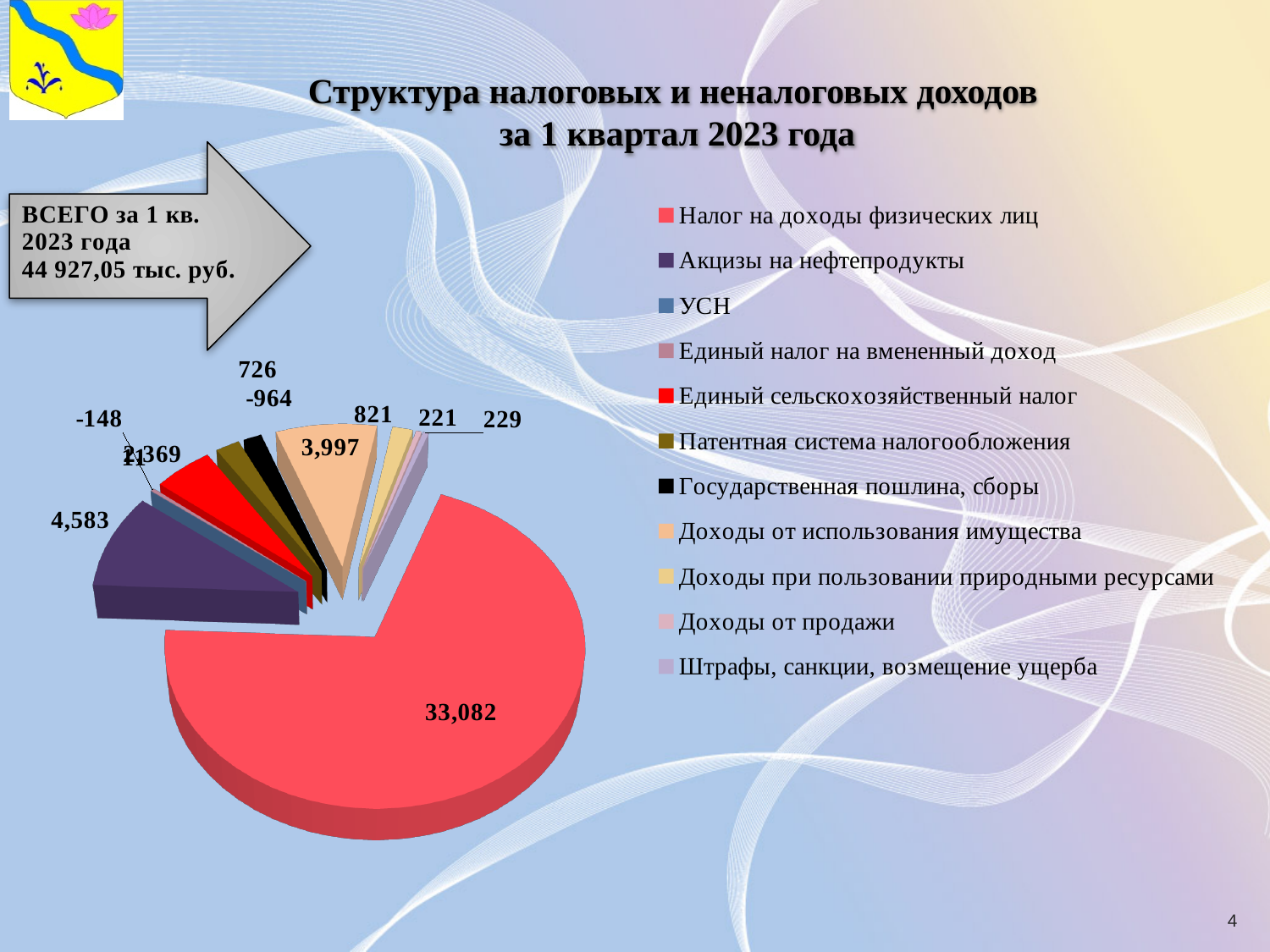
What is the title of the chart on the slide? Структура налоговых и неналоговых доходов за 1 квартал 2023 года Which is larger: the value for Акцизы на нефтепродукты or the value for Доходы от использования имущества? Акцизы на нефтепродукты How many categories does the legend of the pie chart list? 11 What is the value shown for Доходы от использования имущества? 3,997 What is the value shown for Акцизы на нефтепродукты? 4,583 What is the value shown for Налог на доходы физических лиц? 33,082 What is the difference between the values for Акцизы на нефтепродукты and Доходы от использования имущества? 586 What is the difference between the values for Налог на доходы физических лиц and Акцизы на нефтепродукты? 28,499 Which is larger: the value for Налог на доходы физических лиц or the value for Акцизы на нефтепродукты? Налог на доходы физических лиц What kind of chart is shown on the slide? pie chart Which category has the largest slice in the pie chart? Налог на доходы физических лиц According to the text box on the slide, what is the total for the 1st quarter of 2023? 44 927,05 тыс. руб.